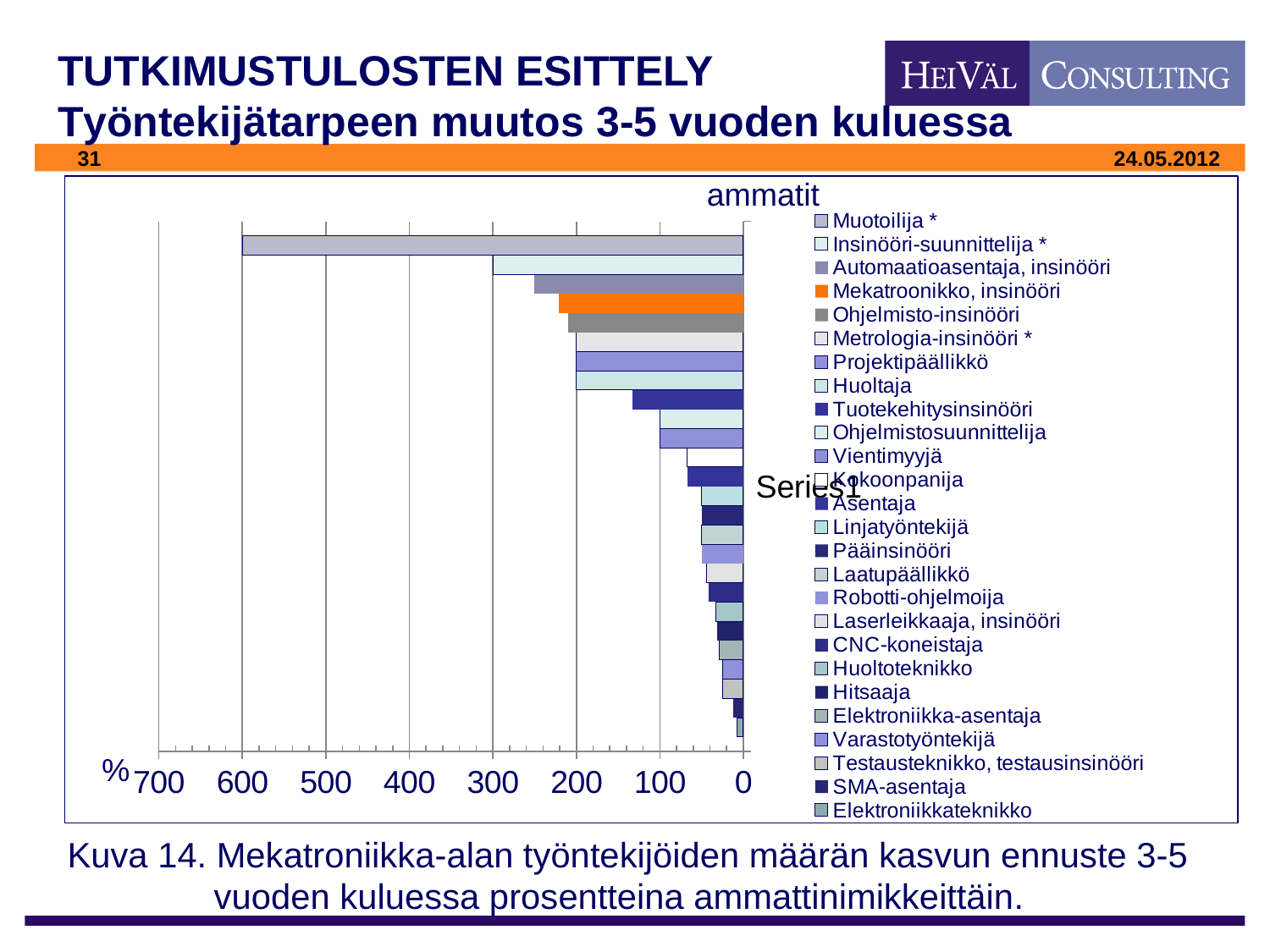
Which category has the highest value in the chart? Muotoilija * Is the value for Automaatioasentaja, insinööri greater or less than 300? less Is the value for Kokoonpanija greater or less than 100? less What kind of chart is shown on the slide? bar chart Is the value for Tuotekehitysinsinööri greater or less than 100? greater How many categories does the chart's legend list? 26 What unit is shown on the chart's value axis? % What is the title of the chart? ammatit Which is larger, the value for Muotoilija * or the value for Insinööri-suunnittelija *? Muotoilija * Which category has the lowest value in the chart? Elektroniikkateknikko